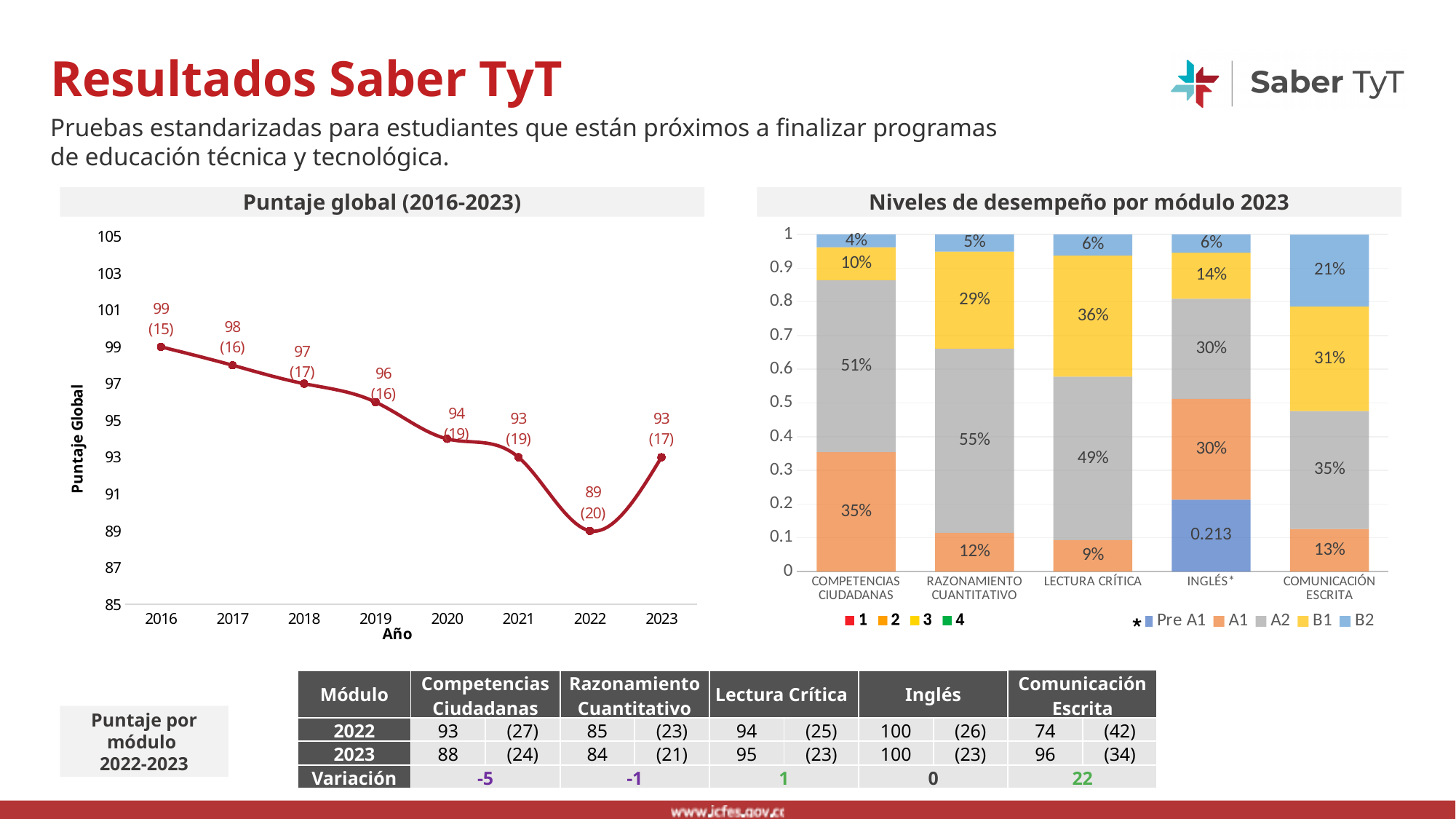
In the 'Niveles de desempeño por módulo 2023' chart, what is the value of the B2 segment for Comunicación Escrita? 21% In the 'Niveles de desempeño por módulo 2023' chart, which module has the largest grey (level 2) segment? Razonamiento Cuantitativo In the 'Puntaje global (2016-2023)' chart, what is the global score for 2022? 89 In the 'Puntaje global (2016-2023)' chart, which year has the highest global score? 2016 In the 'Puntaje global (2016-2023)' chart, what is the difference between the global score in 2023 and in 2022? 4 In the 'Puntaje global (2016-2023)' chart, how many years are plotted? 8 In the 'Niveles de desempeño por módulo 2023' chart, how many modules are shown on the x axis? 5 In the 'Puntaje global (2016-2023)' chart, what is the global score for 2016? 99 In the 'Puntaje global (2016-2023)' chart, does the global score rise or fall from 2016 to 2022? Fall What kind of chart is 'Puntaje global (2016-2023)'? Line chart In the 'Puntaje global (2016-2023)' chart, which year has the lowest global score? 2022 In the 'Niveles de desempeño por módulo 2023' chart, what percentage of Lectura Crítica is at level 3 (yellow segment)? 36%